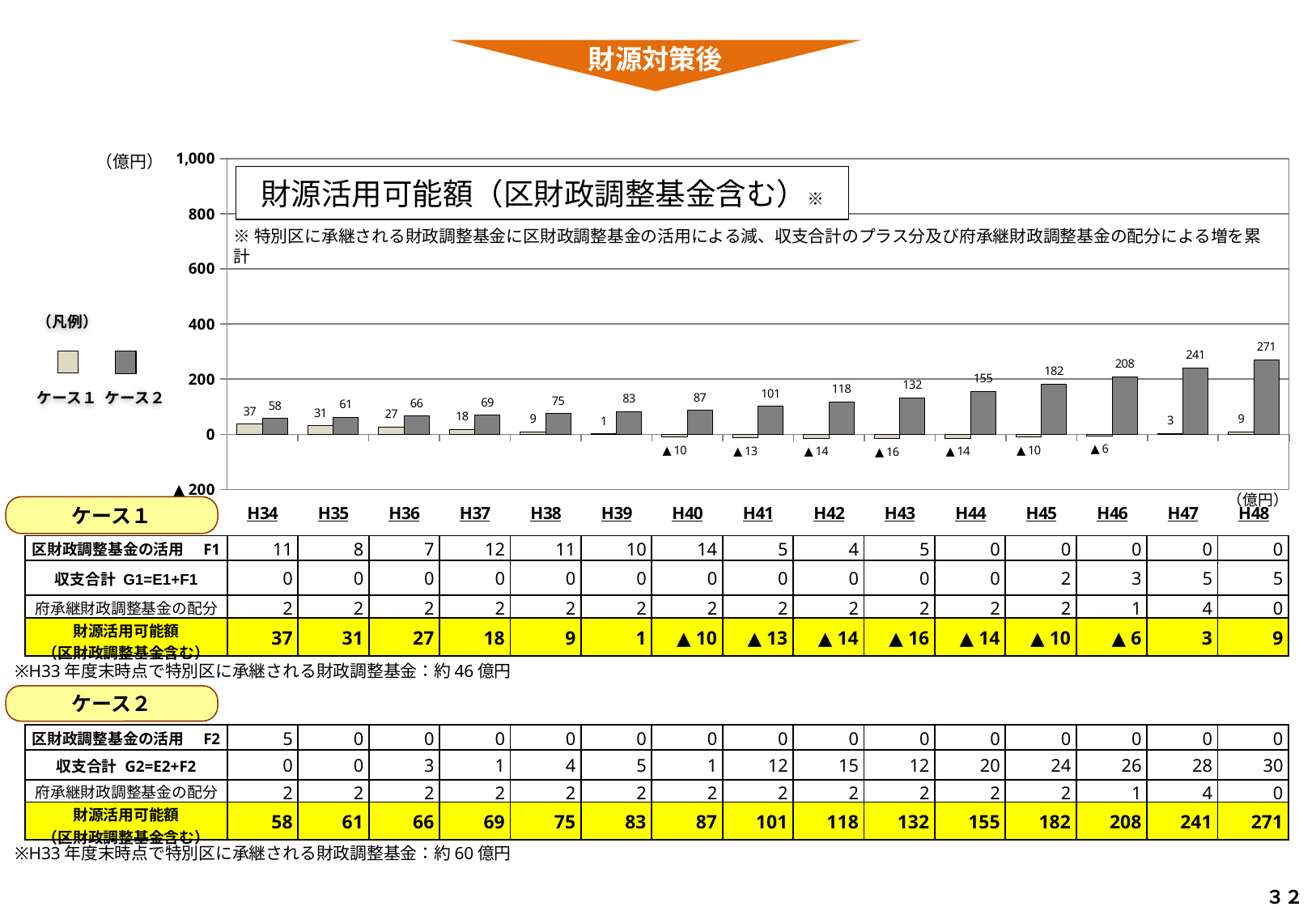
What kind of chart is shown on the slide? bar chart What is the value for ケース2 in H48? 271 Which year has the highest value for ケース2? H48 What is the value for ケース1 in H43? ▲ 16 Is the value for ケース2 in H48 greater or less than 200? greater What is the difference between ケース2 and ケース1 in H34? 21 What is the difference between the ケース2 values in H48 and H47? 30 How many series does the legend list? 2 How many years are shown on the x axis of the chart? 15 What is the value for ケース1 in H34? 37 Which is larger in H39, ケース1 or ケース2? ケース2 Which year has the lowest value for ケース1? H43